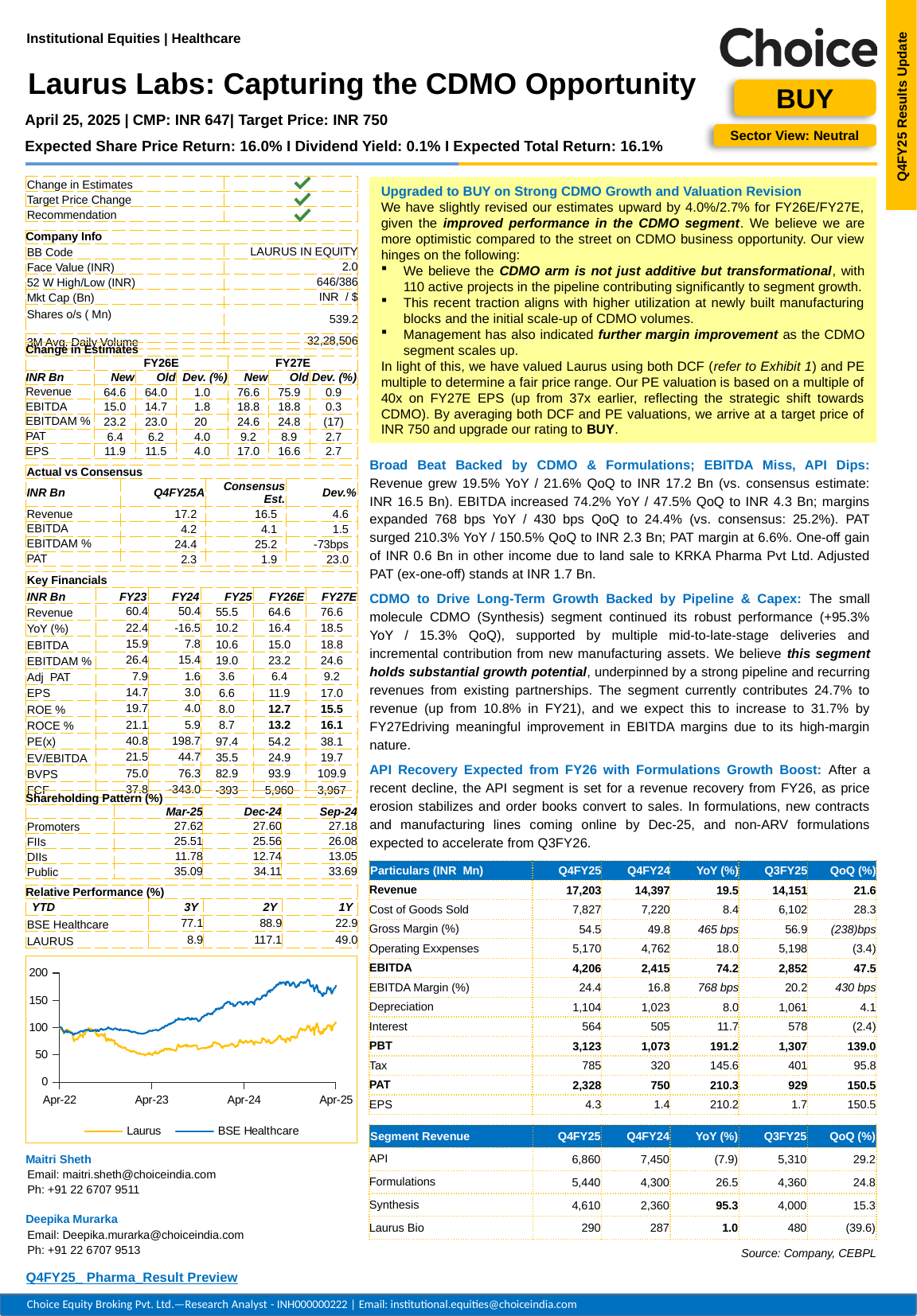
In the line chart, does the BSE Healthcare line rise or fall overall from Apr-22 to Apr-25? rise How many series does the legend of the line chart list? 2 In the line chart, is the value for Laurus at Apr-25 greater or less than 150? less In the line chart, which series reaches the highest value over the period shown? BSE Healthcare What are the two series named in the legend of the line chart? Laurus and BSE Healthcare In the line chart, which series is higher at Apr-25, Laurus or BSE Healthcare? BSE Healthcare What kind of chart is shown at the bottom left of the slide? line chart In the line chart, is the value for BSE Healthcare at Apr-25 greater or less than 150? greater In the line chart, is the lowest value of the Laurus line greater or less than 100? less In the line chart, which colour is used for the Laurus line? yellow How many date labels are shown on the x axis of the line chart? 4